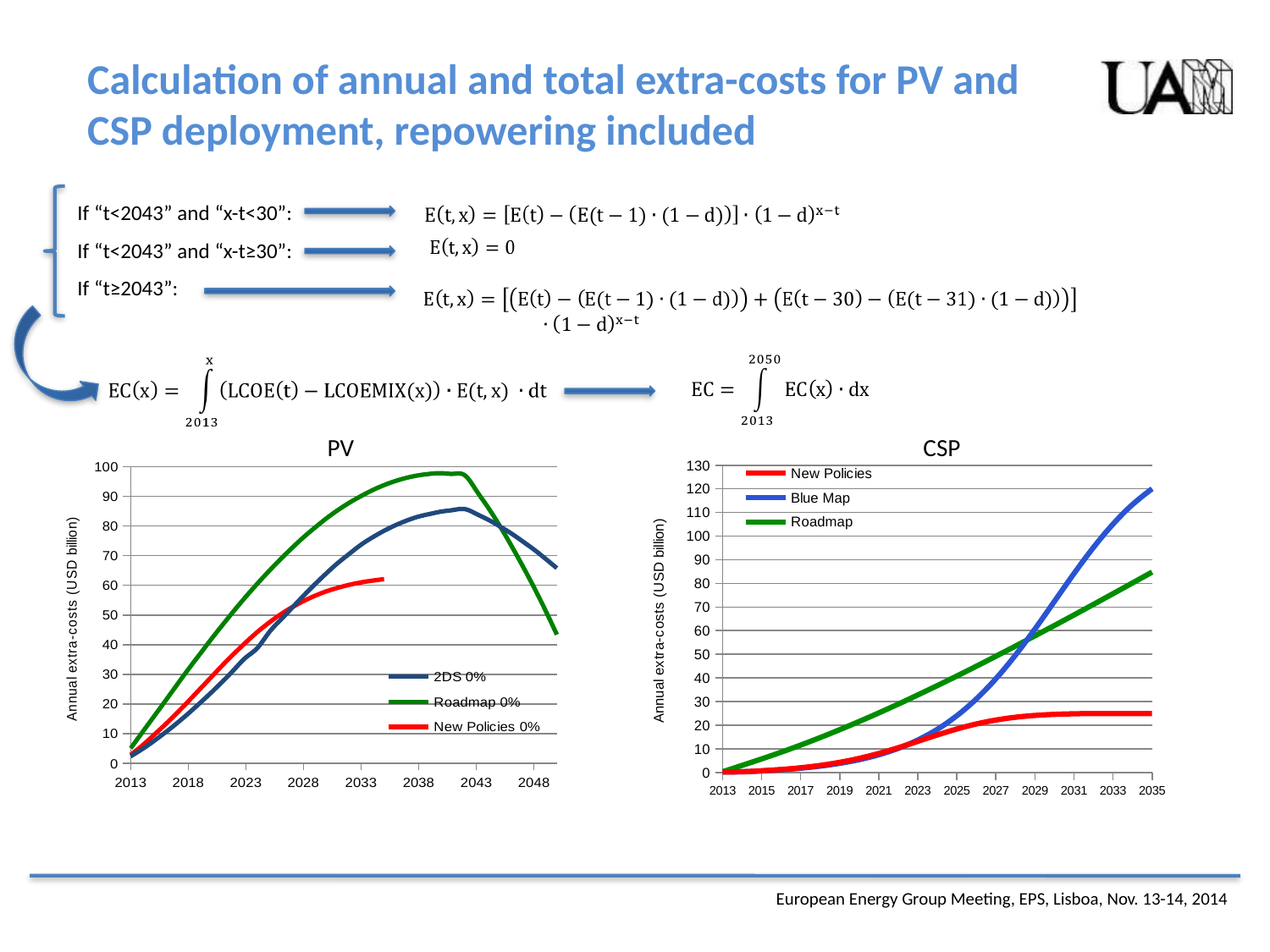
In the CSP chart, which series has the highest value in 2035? Blue Map In the PV chart, which series reaches the highest peak value? Roadmap 0% In the CSP chart, which is larger in 2021: Roadmap or Blue Map? Roadmap In the CSP chart, does the Blue Map series rise or fall from 2013 to 2035? rise How many series does the legend of the CSP chart list? 3 In the CSP chart, is the value for Blue Map in 2035 greater or less than 110? greater What kind of chart is the PV chart? line chart In the CSP chart, is the value for New Policies in 2035 greater or less than 30? less What is the y-axis label of the CSP chart? Annual extra-costs (USD billion) In the PV chart, is the value for New Policies 0% in 2023 greater or less than 50? less In the PV chart, which series are listed in the legend? 2DS 0%, Roadmap 0%, New Policies 0%